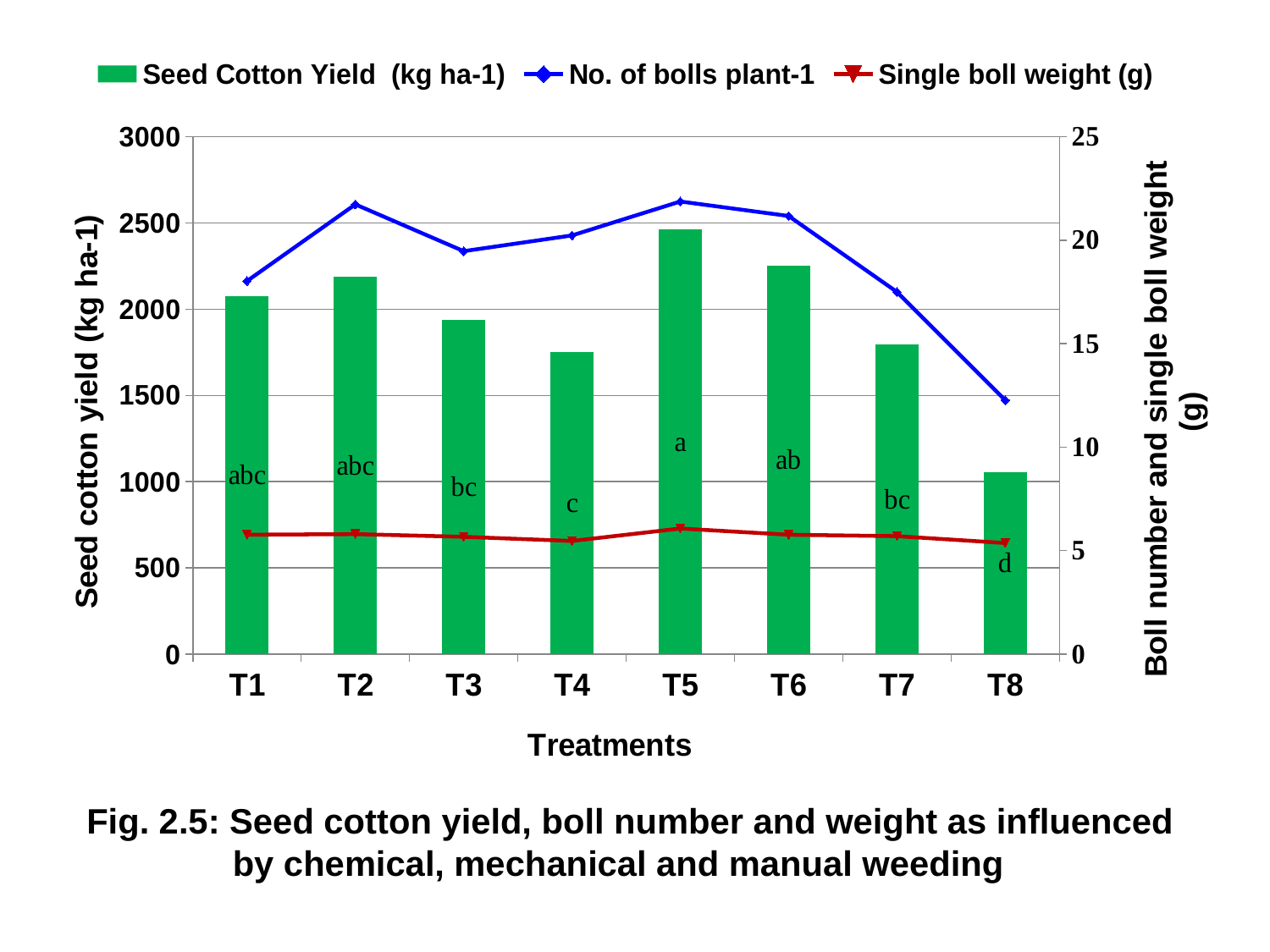
How many series does the legend list? 3 Which treatment has the lowest seed cotton yield bar? T8 What letter label is printed on the T5 bar? a Does the number of bolls per plant rise or fall from T5 to T8? fall Is the number of bolls per plant for T2 greater or less than 20? greater Is the seed cotton yield for T4 greater or less than 2000? less Which has the larger seed cotton yield, T2 or T3? T2 How many treatments are shown on the x axis? 8 What kind of chart is shown on the slide? Combined bar and line chart Which treatment has the highest seed cotton yield bar? T5 Which treatment has the lowest number of bolls per plant? T8 Is the seed cotton yield for T8 greater or less than 1500? less